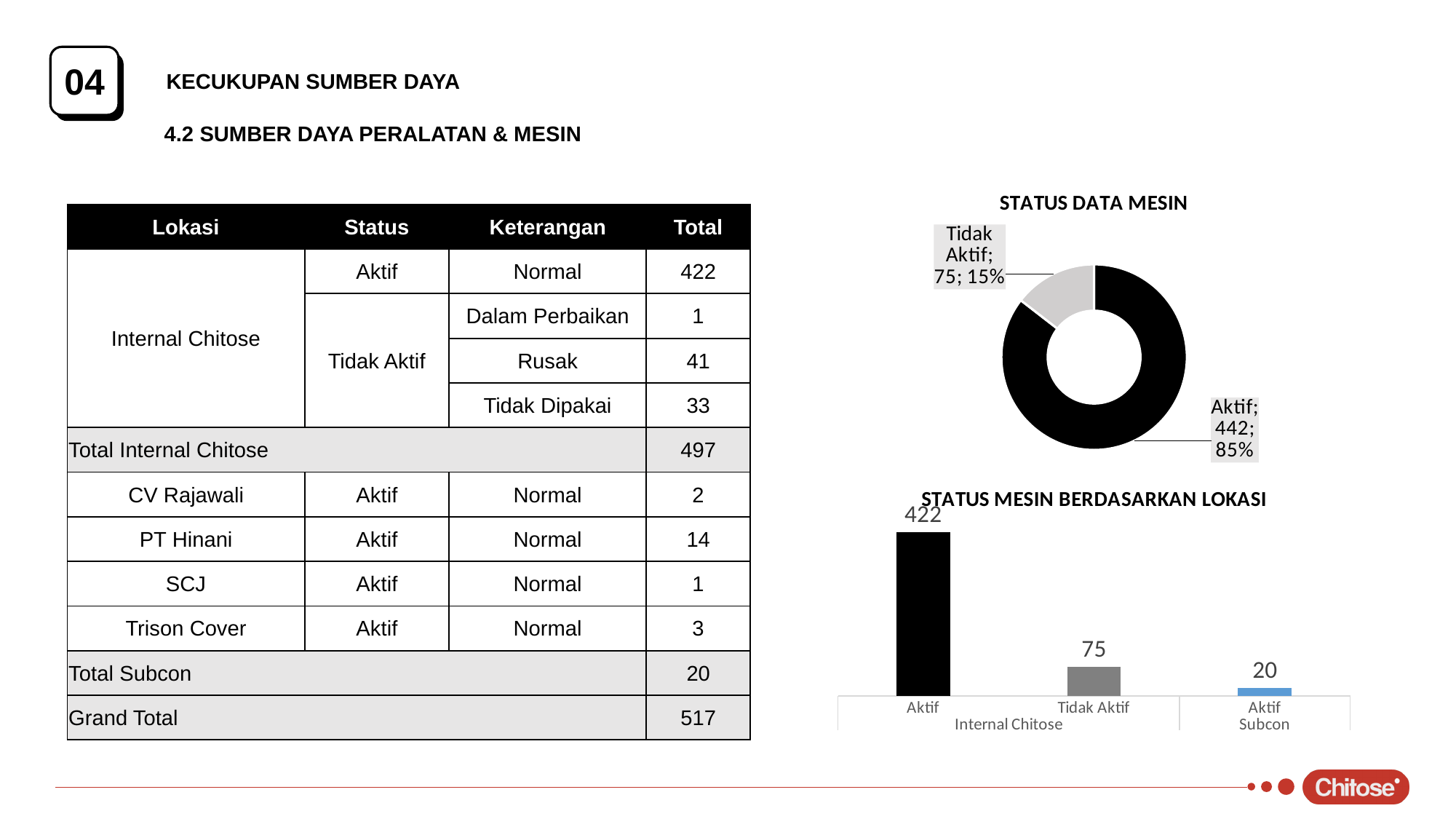
In the STATUS MESIN BERDASARKAN LOKASI chart, which bar is the lowest? Aktif (Subcon) How many slices does the STATUS DATA MESIN chart have? 2 What kind of chart is STATUS MESIN BERDASARKAN LOKASI? Bar chart In the STATUS MESIN BERDASARKAN LOKASI chart, what is the value of the Aktif bar for Subcon? 20 In the STATUS MESIN BERDASARKAN LOKASI chart, which bar is the highest? Aktif (Internal Chitose) In the STATUS DATA MESIN chart, what share of the total does Tidak Aktif represent? 15% What kind of chart is STATUS DATA MESIN? Doughnut chart In the STATUS DATA MESIN chart, what value is shown for Aktif? 442 In the STATUS DATA MESIN chart, what share of the total does Aktif represent? 85% In the STATUS MESIN BERDASARKAN LOKASI chart, what is the difference between the Tidak Aktif bar for Internal Chitose and the Aktif bar for Subcon? 55 In the STATUS DATA MESIN chart, what value is shown for Tidak Aktif? 75 In the STATUS MESIN BERDASARKAN LOKASI chart, what is the value of the Aktif bar for Internal Chitose? 422